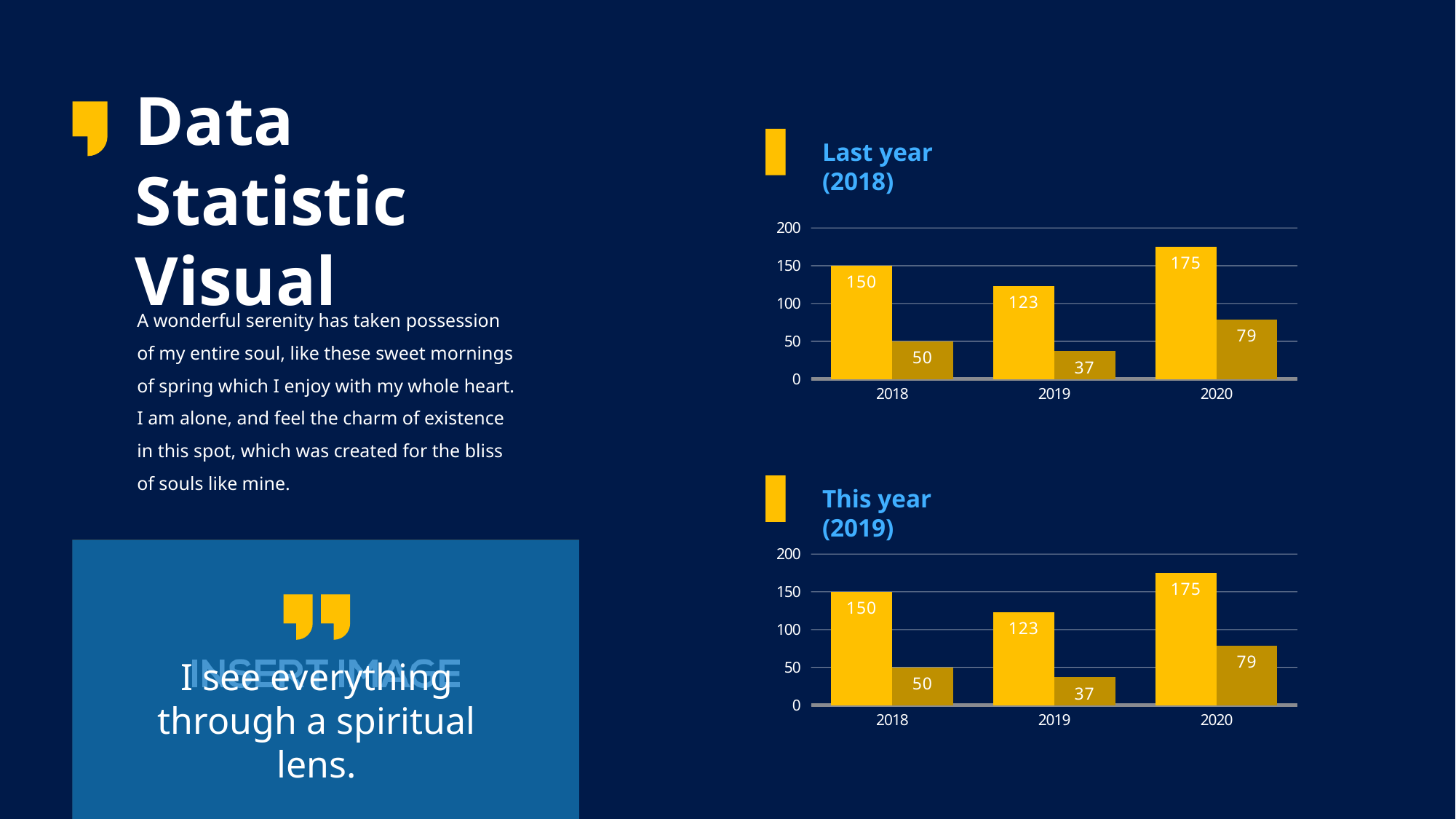
In the 'Last year (2018)' chart, what is the difference between the brighter yellow bar and the darker gold bar for 2020? 96 In the 'This year (2019)' chart, which year has the lowest darker gold bar? 2019 In the 'Last year (2018)' chart, which year has the highest brighter yellow bar? 2020 What type of chart is the 'Last year (2018)' chart? Bar chart How many year categories are shown on the x axis of the 'This year (2019)' chart? 3 In the 'This year (2019)' chart, what is the value of the brighter yellow bar for 2019? 123 What is the title of the lower chart on the slide? This year (2019) In the 'Last year (2018)' chart, what is the value of the brighter yellow bar for 2020? 175 In the 'This year (2019)' chart, what is the difference between the brighter yellow bars for 2020 and 2018? 25 In the 'This year (2019)' chart, what is the value of the darker gold bar for 2018? 50 In the 'Last year (2018)' chart, what is the value of the darker gold bar for 2019? 37 In the 'Last year (2018)' chart, which is larger: the darker gold bar for 2018 or the darker gold bar for 2020? 2020